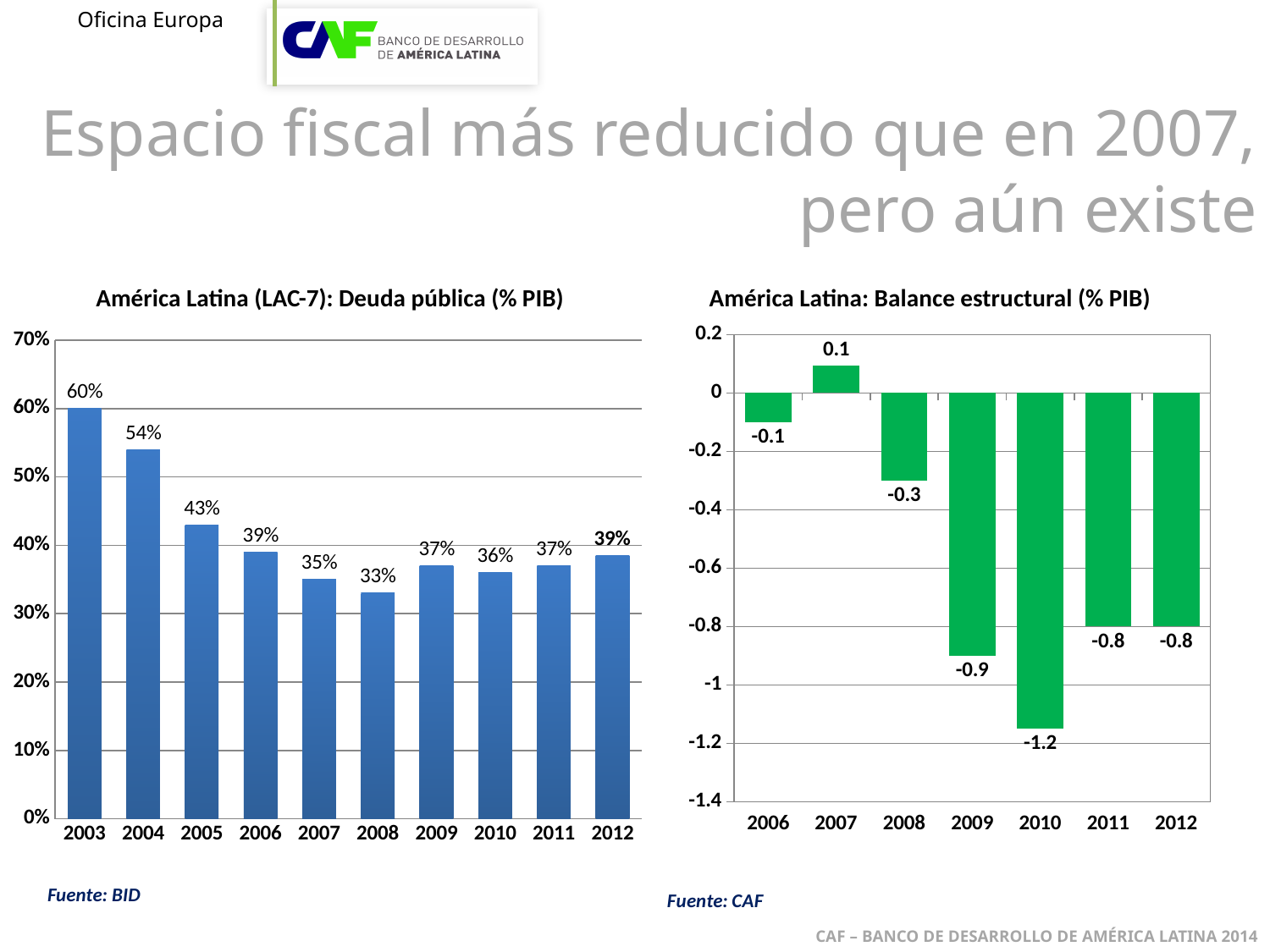
In the 'América Latina (LAC-7): Deuda pública (% PIB)' chart, which year has the lowest public debt? 2008 In the 'América Latina (LAC-7): Deuda pública (% PIB)' chart, what is the difference between the values for 2003 and 2004? 6% What kind of chart is the 'América Latina: Balance estructural (% PIB)' chart? bar chart In the 'América Latina: Balance estructural (% PIB)' chart, which year has the highest structural balance? 2007 In the 'América Latina (LAC-7): Deuda pública (% PIB)' chart, is the value for 2005 larger or smaller than the value for 2006? larger In the 'América Latina (LAC-7): Deuda pública (% PIB)' chart, which year has the highest public debt? 2003 In the 'América Latina: Balance estructural (% PIB)' chart, which year has the lowest structural balance? 2010 What is the source cited below the 'América Latina (LAC-7): Deuda pública (% PIB)' chart? BID In the 'América Latina: Balance estructural (% PIB)' chart, how many years are shown on the x axis? 7 In the 'América Latina: Balance estructural (% PIB)' chart, what is the value for 2010? -1.2 In the 'América Latina (LAC-7): Deuda pública (% PIB)' chart, what is the value for 2003? 60% In the 'América Latina (LAC-7): Deuda pública (% PIB)' chart, how many years are shown on the x axis? 10